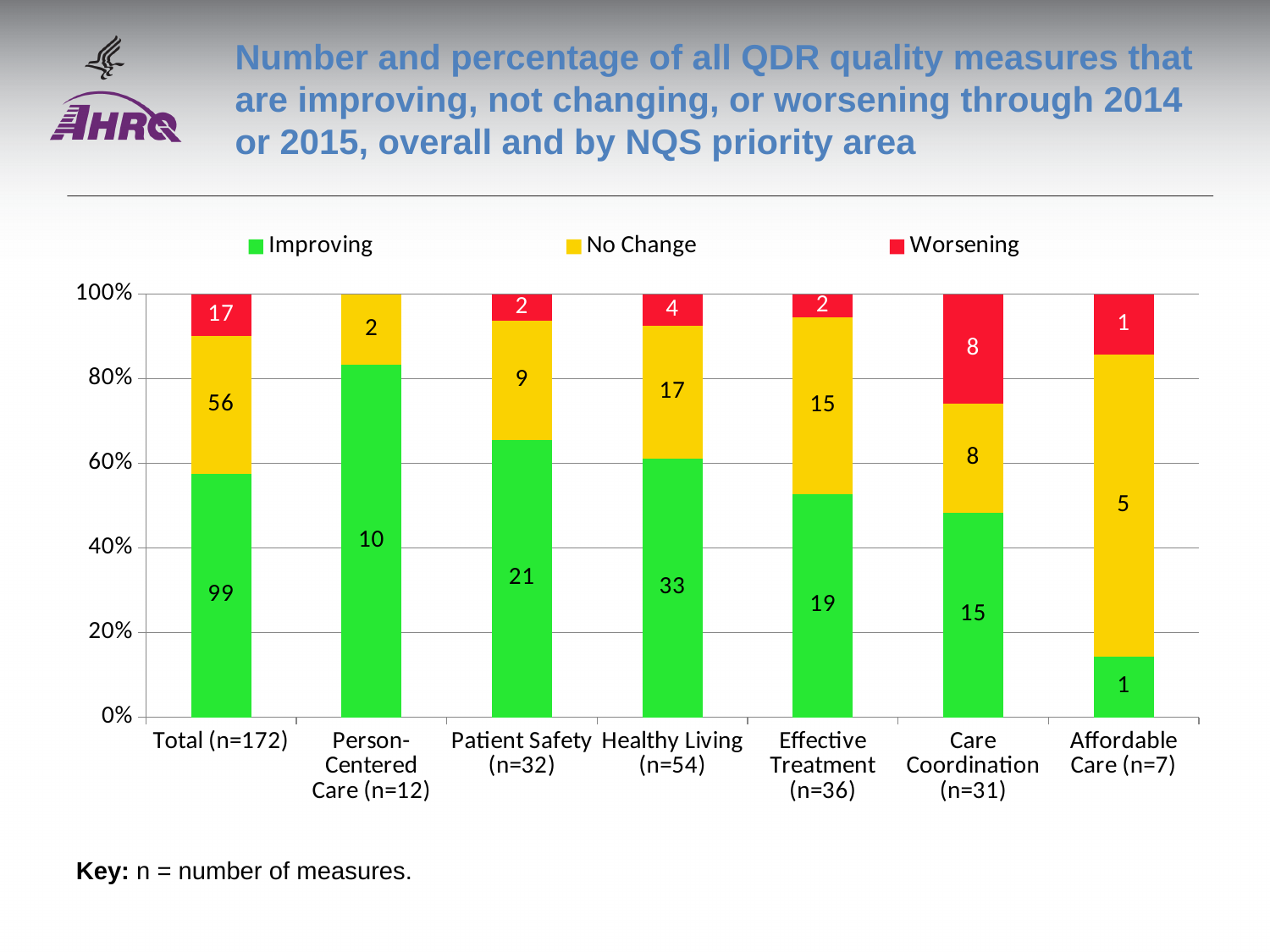
What is the No Change value for Healthy Living (n=54)? 17 How many series does the legend list? 3 What is the difference between the Improving and No Change values for Patient Safety (n=32)? 12 What is the Improving value for Affordable Care (n=7)? 1 Which category has the lowest No Change value? Person-Centered Care (n=12) What colour represents the Worsening series in the legend? Red Among the NQS priority areas (excluding Total), which category has the highest Improving value? Healthy Living (n=54) What is the Worsening value for Care Coordination (n=31)? 8 What is the Improving value for Total (n=172)? 99 Which is larger, the Improving value for Effective Treatment (n=36) or the Improving value for Care Coordination (n=31)? Effective Treatment (n=36) What kind of chart is shown on the slide? Stacked bar chart How many categories are shown along the x axis? 7